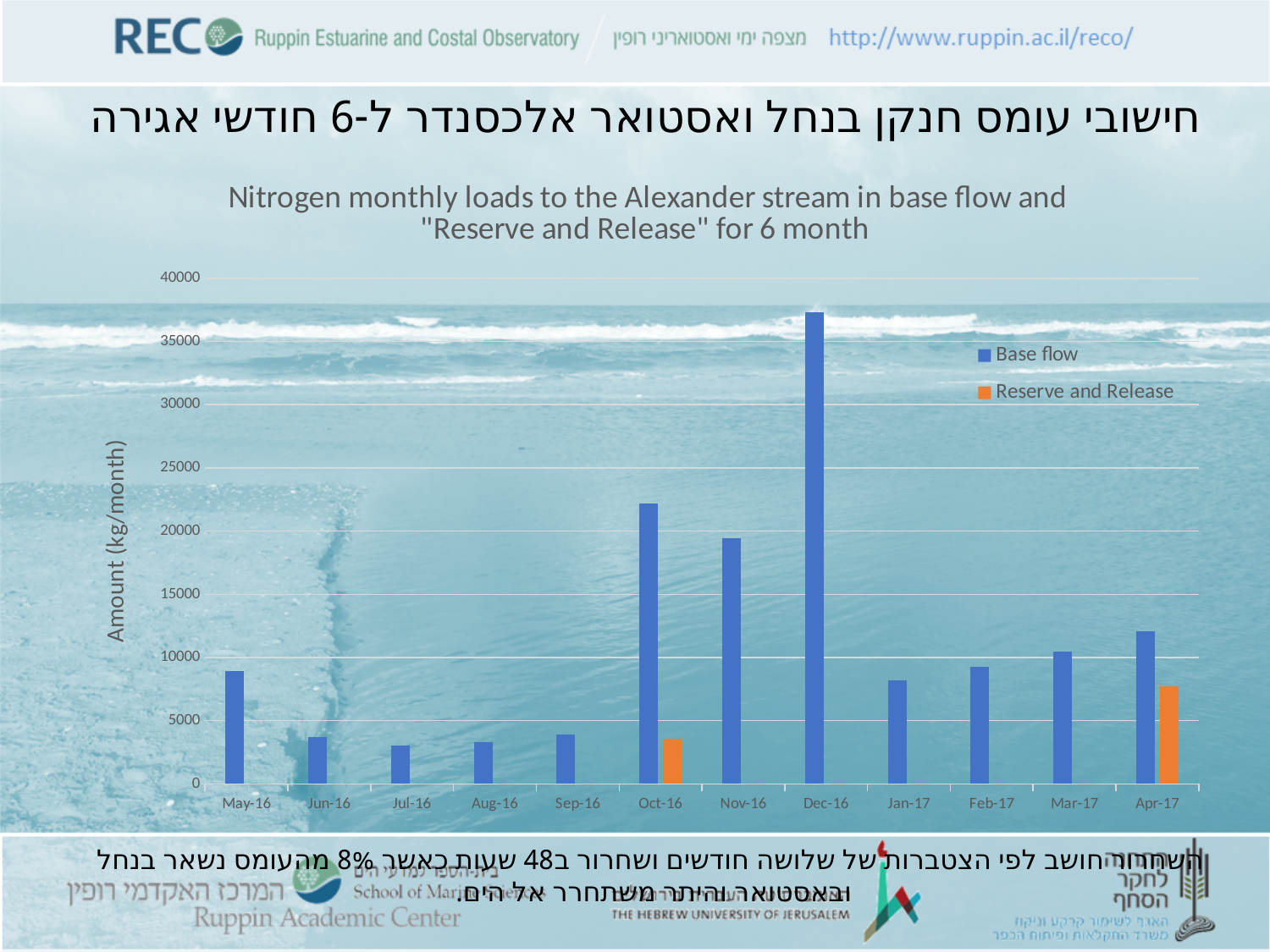
How many months are shown on the x axis? 12 Is the Base flow value for Dec-16 greater or less than 35000? greater How many series does the legend list? 2 What is the label of the y axis? Amount (kg/month) Is the Base flow value for Oct-16 greater or less than 20000? greater Is the Reserve and Release value for Oct-16 greater or less than 5000? less Which is larger, the Base flow value for Oct-16 or for Nov-16? Oct-16 Which month has the highest Base flow value? Dec-16 In how many months does a Reserve and Release bar appear? 2 What kind of chart is shown on the slide? bar chart